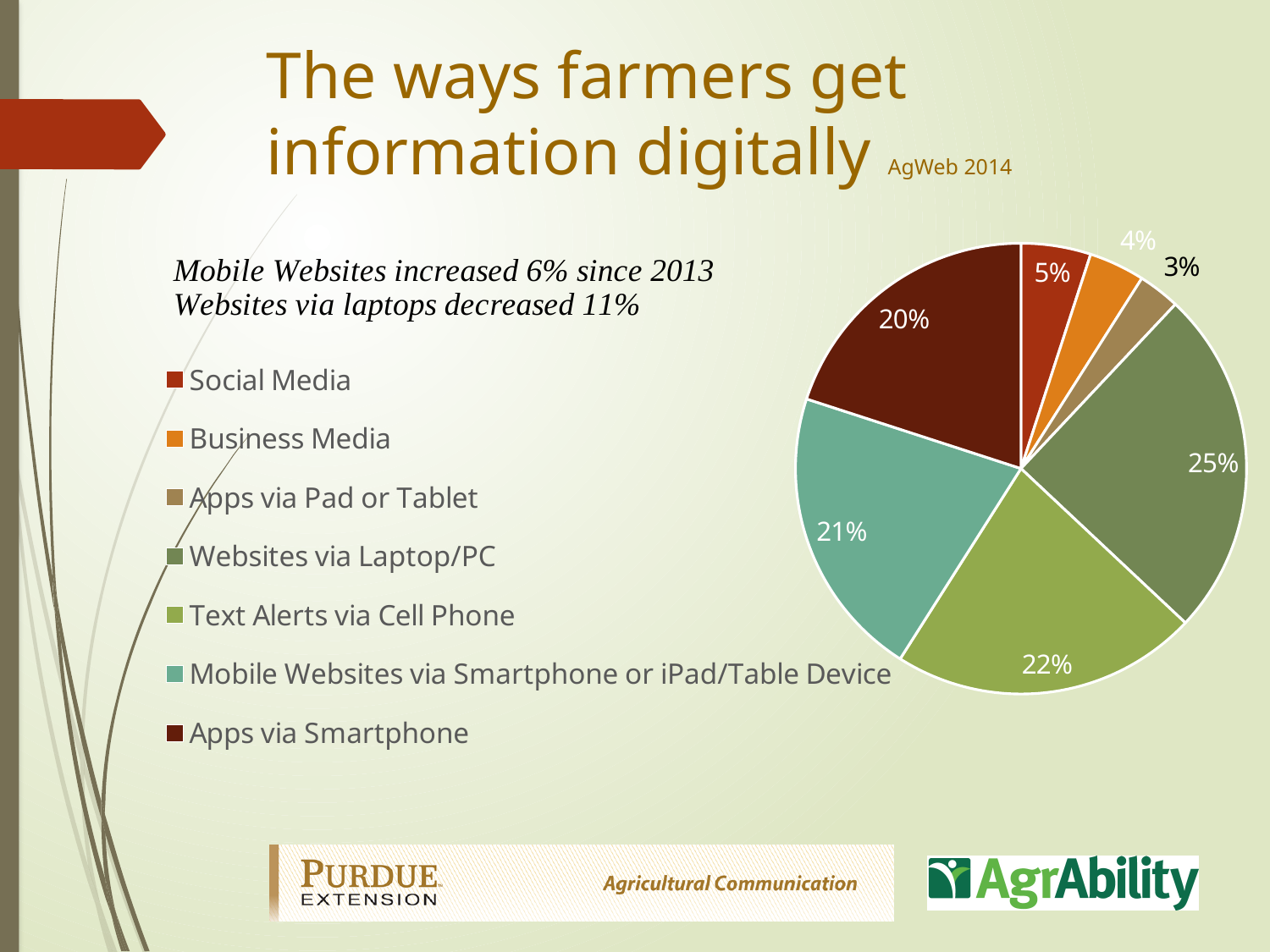
What is the title of the slide containing the pie chart? The ways farmers get information digitally What is the difference in percentage points between Websites via Laptop/PC and Apps via Smartphone? 5 Which is larger, Business Media or Social Media? Social Media What kind of chart is shown on the slide? pie chart What percentage of the pie is Text Alerts via Cell Phone? 22% What percentage of the pie is Websites via Laptop/PC? 25% How many categories does the pie chart have? 7 Which category has the largest share of the pie? Websites via Laptop/PC Which category has the smallest share of the pie? Apps via Pad or Tablet What percentage of the pie is Apps via Smartphone? 20% What percentage of the pie is Social Media? 5% What is the combined share of Social Media, Business Media and Apps via Pad or Tablet? 12%